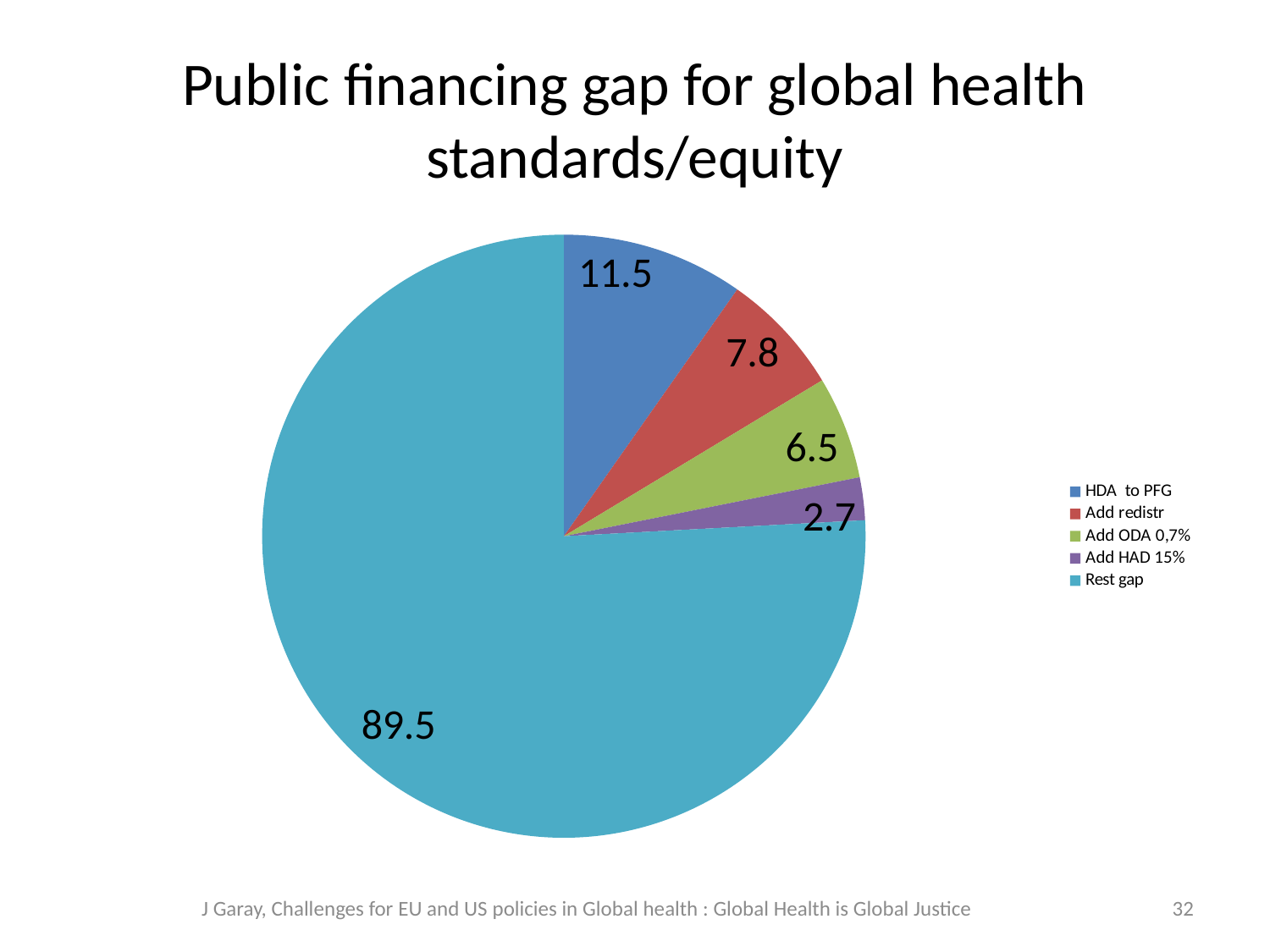
Which slice of the pie is the largest? Rest gap What value is shown for the Add HAD 15% slice? 2.7 Which slice of the pie is the smallest? Add HAD 15% What is the difference between the HDA to PFG value and the Add redistr value? 3.7 What value is shown for the Rest gap slice? 89.5 What value is shown for the Add redistr slice? 7.8 How many slices does the pie chart have? 5 What value is shown for the HDA to PFG slice? 11.5 Which is larger, the Add ODA 0,7% slice or the Add HAD 15% slice? Add ODA 0,7% What value is shown for the Add ODA 0,7% slice? 6.5 What is the title of the chart on the slide? Public financing gap for global health standards/equity What kind of chart is shown on the slide? Pie chart